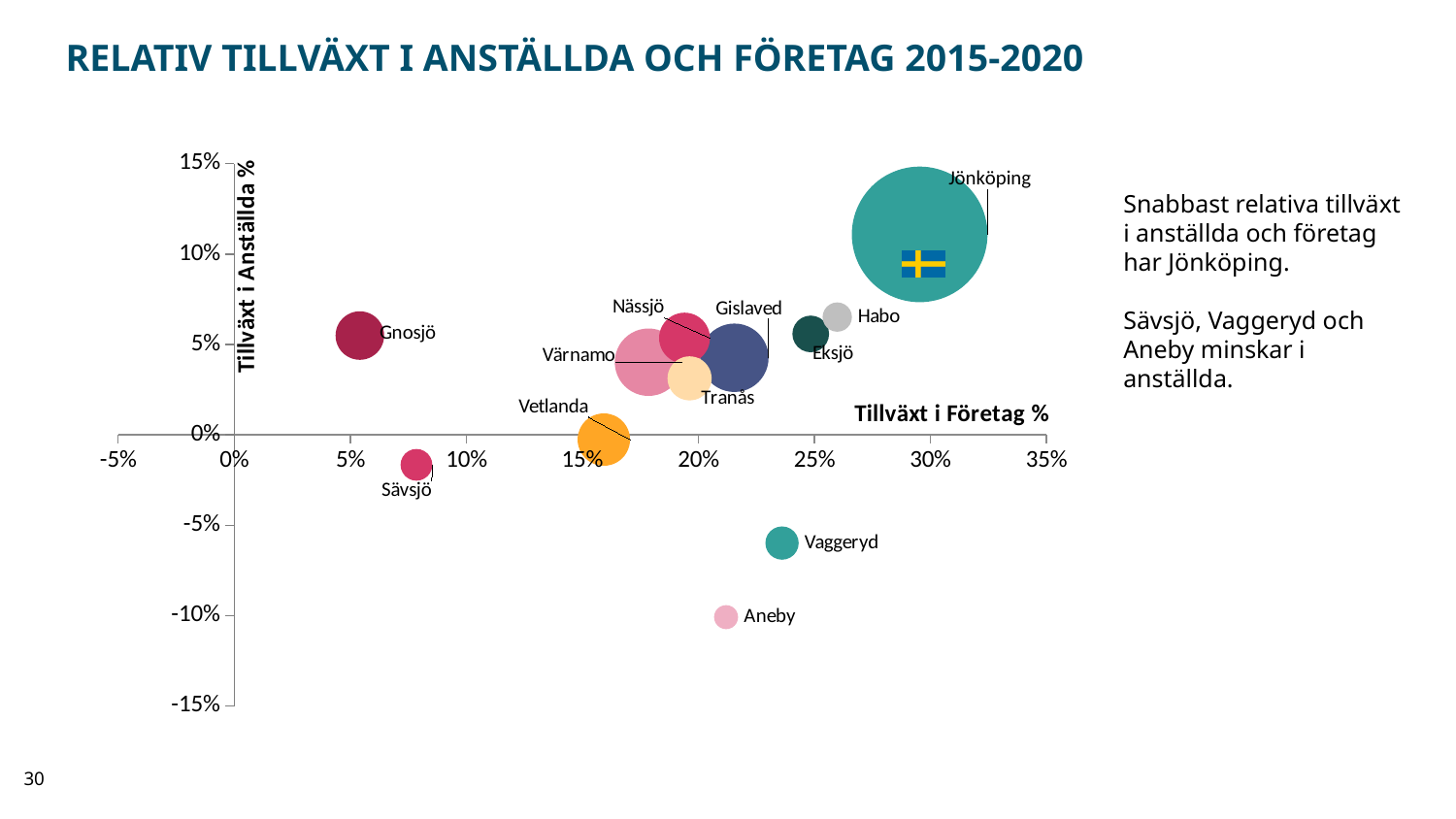
How many municipalities are plotted in the chart? 12 Is the growth in employees for Jönköping greater or less than 10%? greater Which municipality has the lowest growth in companies (Tillväxt i Företag %)? Gnosjö What is the label of the horizontal axis? Tillväxt i Företag % Is the growth in employees for Aneby greater or less than -5%? less Which municipality has the lowest growth in employees (Tillväxt i Anställda %)? Aneby Which has higher growth in companies, Jönköping or Habo? Jönköping Is the growth in companies for Gnosjö greater or less than 10%? less Which municipality has the highest growth in employees (Tillväxt i Anställda %)? Jönköping What kind of chart is shown on the slide? Bubble chart Which has higher growth in employees, Gnosjö or Sävsjö? Gnosjö